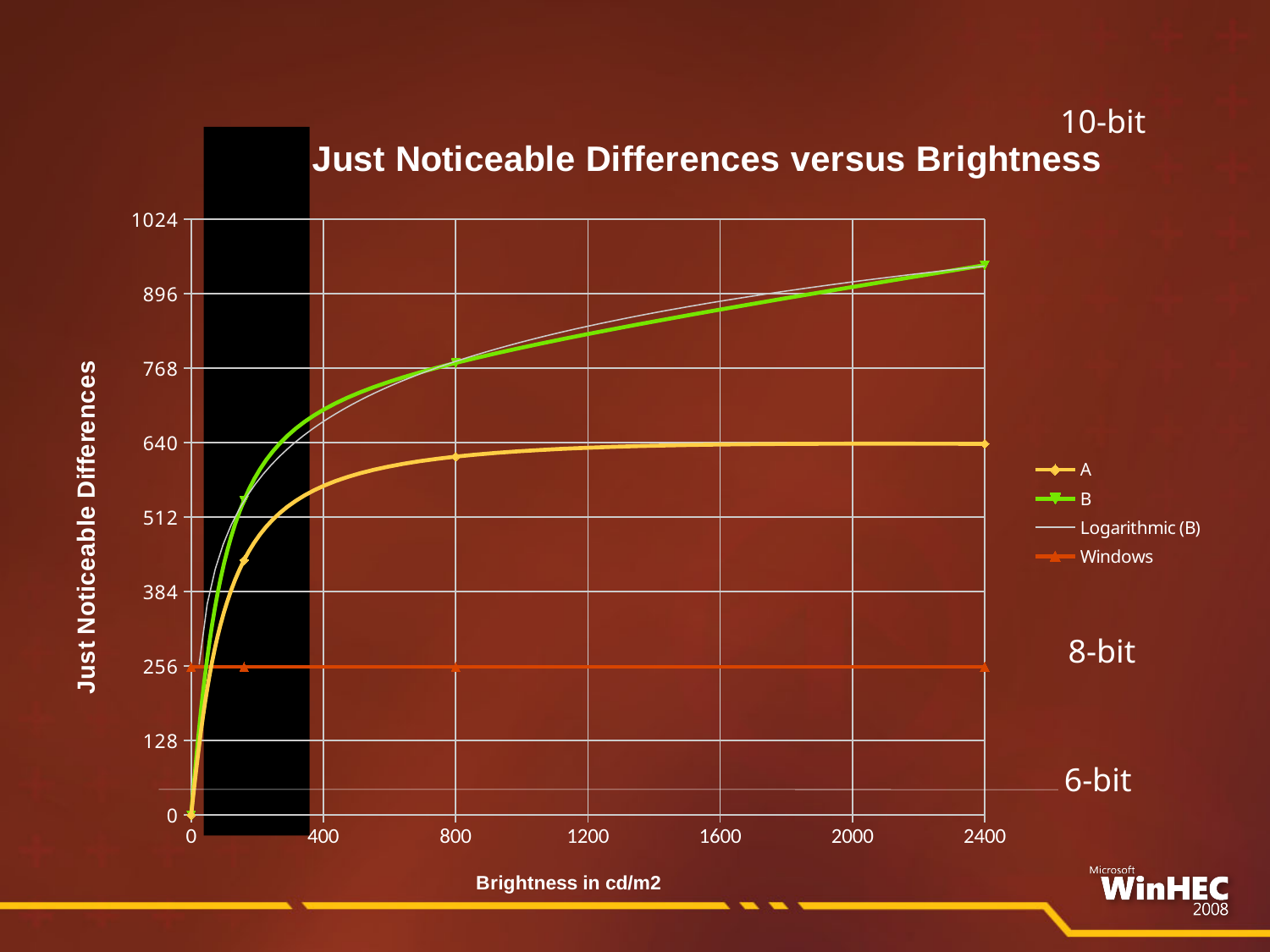
Is the value for A at a brightness of 800 greater or less than 512? greater How many series does the legend list? 4 What kind of chart is shown on the slide? line chart What is the label of the x axis? Brightness in cd/m2 Does the B series rise or fall as brightness increases along the x axis? rise At a brightness of 2400, which is larger, the value for A or the value for B? B Which series has the highest value at a brightness of 2400? B Which series has the lowest value at a brightness of 2400? Windows Is the value for B at a brightness of 2400 greater or less than 896? greater What is the title of the chart? Just Noticeable Differences versus Brightness Is the value for B at a brightness of 800 greater or less than 640? greater